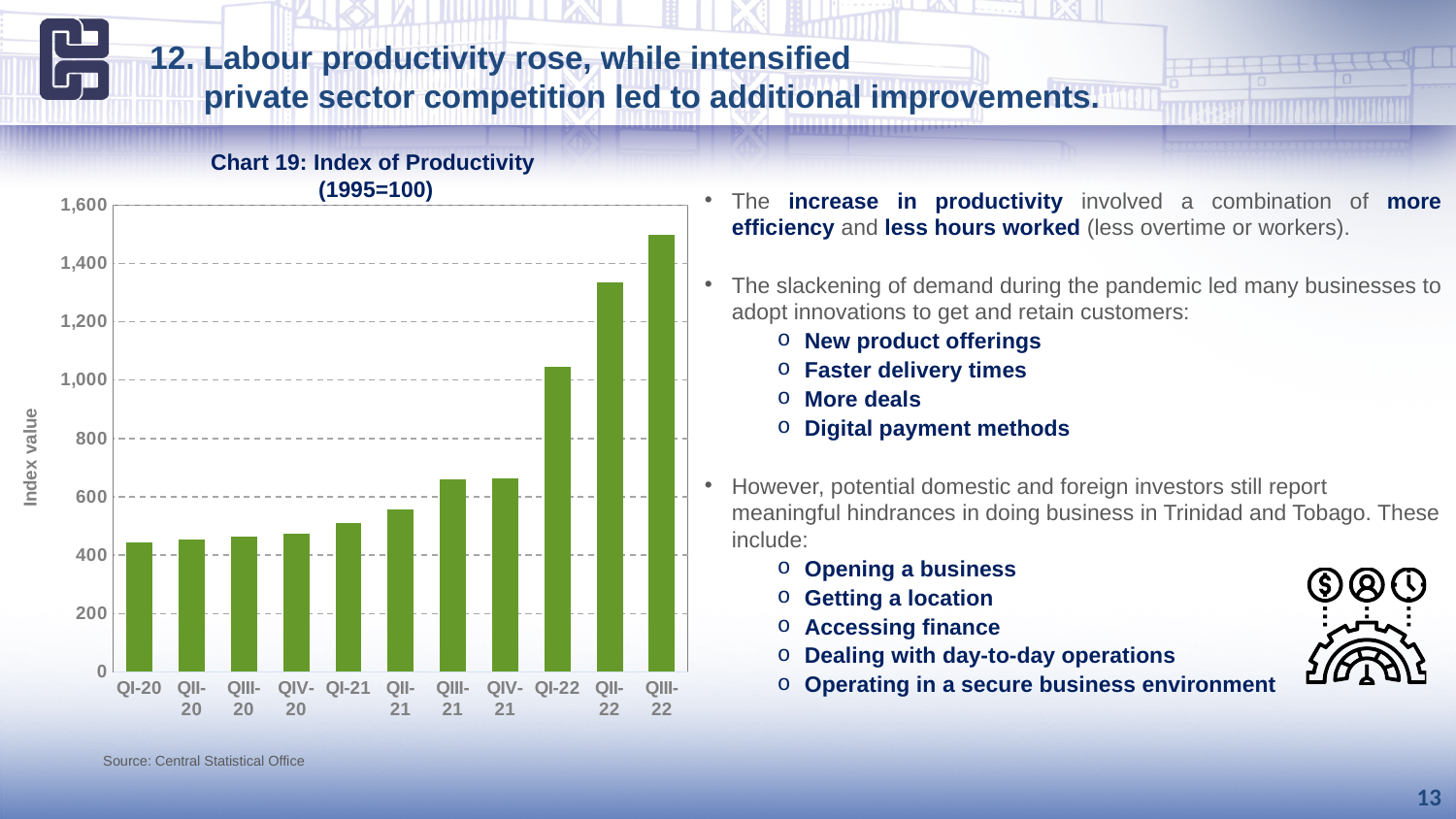
In Chart 19, is the index value for QIII-22 greater or less than 1,400? greater In Chart 19, is the index value for QI-20 greater or less than 600? less What kind of chart is Chart 19: Index of Productivity? bar chart How many quarters are plotted in Chart 19: Index of Productivity? 11 In Chart 19, is the index value for QII-21 greater or less than 600? less What is the label on the vertical axis of Chart 19? Index value Do the index values in Chart 19 generally rise or fall from QI-20 to QIII-22? rise Which quarter has the highest index value in Chart 19? QIII-22 Which quarter has the lowest index value in Chart 19? QI-20 In Chart 19, which has the larger index value, QII-22 or QI-22? QII-22 What is the base year shown in the title of Chart 19? 1995=100